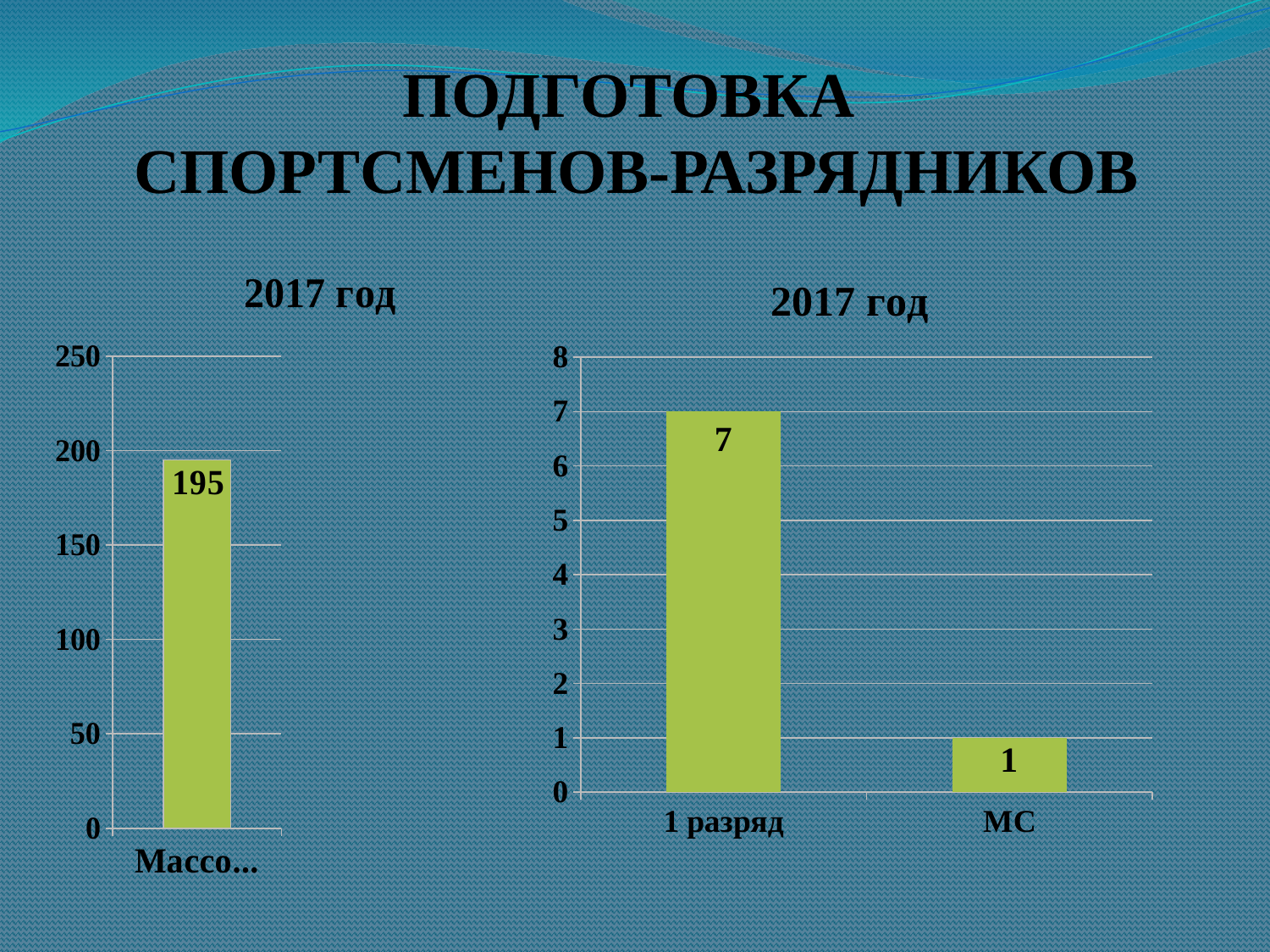
How many bars are shown in the left chart? 1 In the left chart, what value is shown on the single bar? 195 In the right chart, what is the value for 1 разряд? 7 In the right chart, what is the value for МС? 1 What is the title of the right chart? 2017 год How many categories are shown in the right chart? 2 What type of chart is the right chart? bar chart In the right chart, which is larger: the value for 1 разряд or the value for МС? 1 разряд In the right chart, what is the difference between the values for 1 разряд and МС? 6 In the right chart, which category has the lowest value? МС In the left chart, is the value of the bar greater or less than 150? greater In the right chart, which category has the highest value? 1 разряд